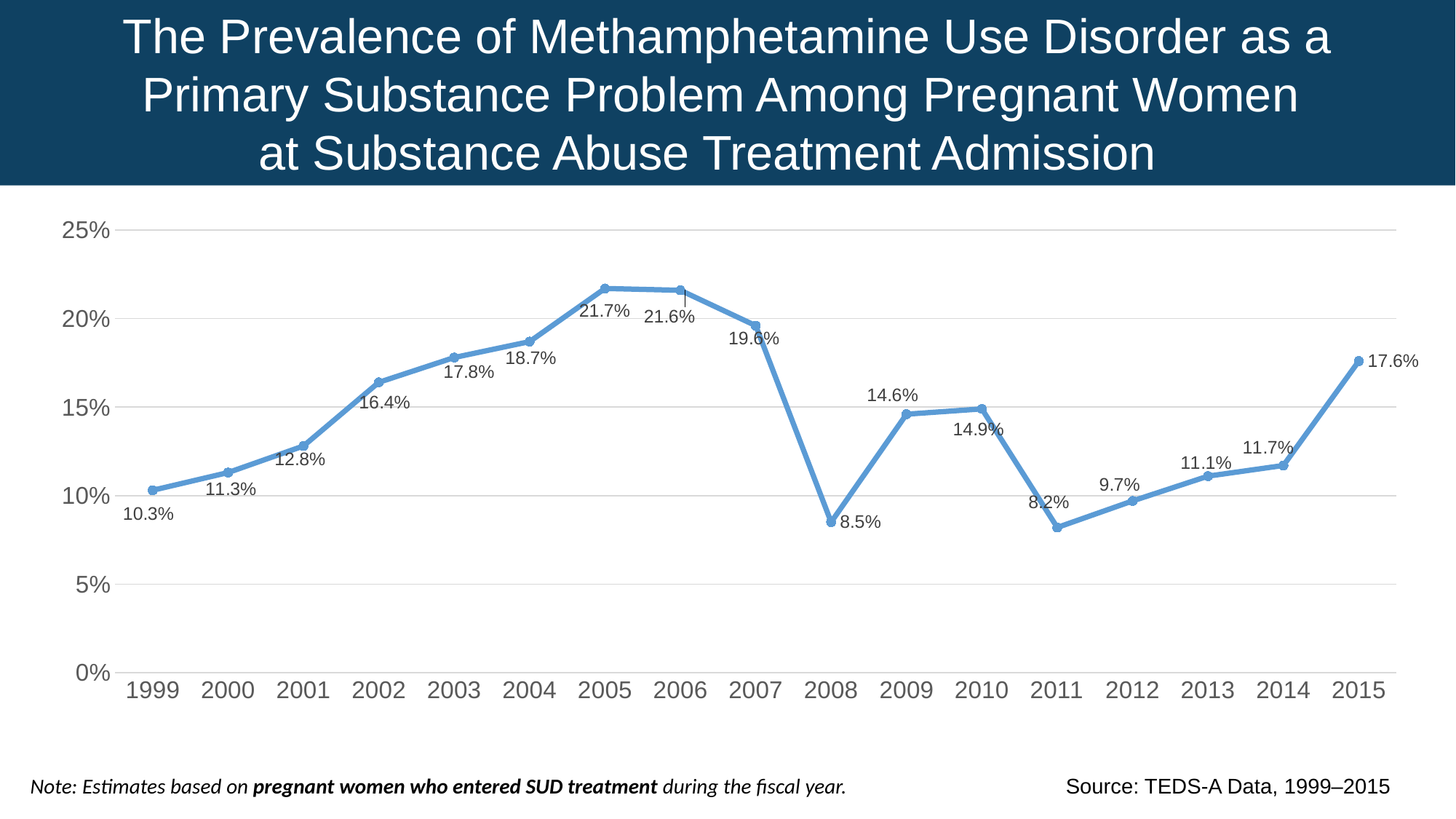
Which year has the highest prevalence? 2005 Do the values rise or fall from 1999 to 2005? rise What is the prevalence value for 2011? 8.2% What is the prevalence value for 2015? 17.6% What is the prevalence value for 2005? 21.7% What kind of chart is shown on the slide? line chart Which year has the lowest prevalence? 2011 How many years are plotted on the x axis? 17 What data source is cited on the slide? TEDS-A Data, 1999–2015 What is the difference between the values for 2007 and 2008? 11.1% Which year has a larger value, 2009 or 2010? 2010 Is the value for 2004 greater or less than 15%? greater